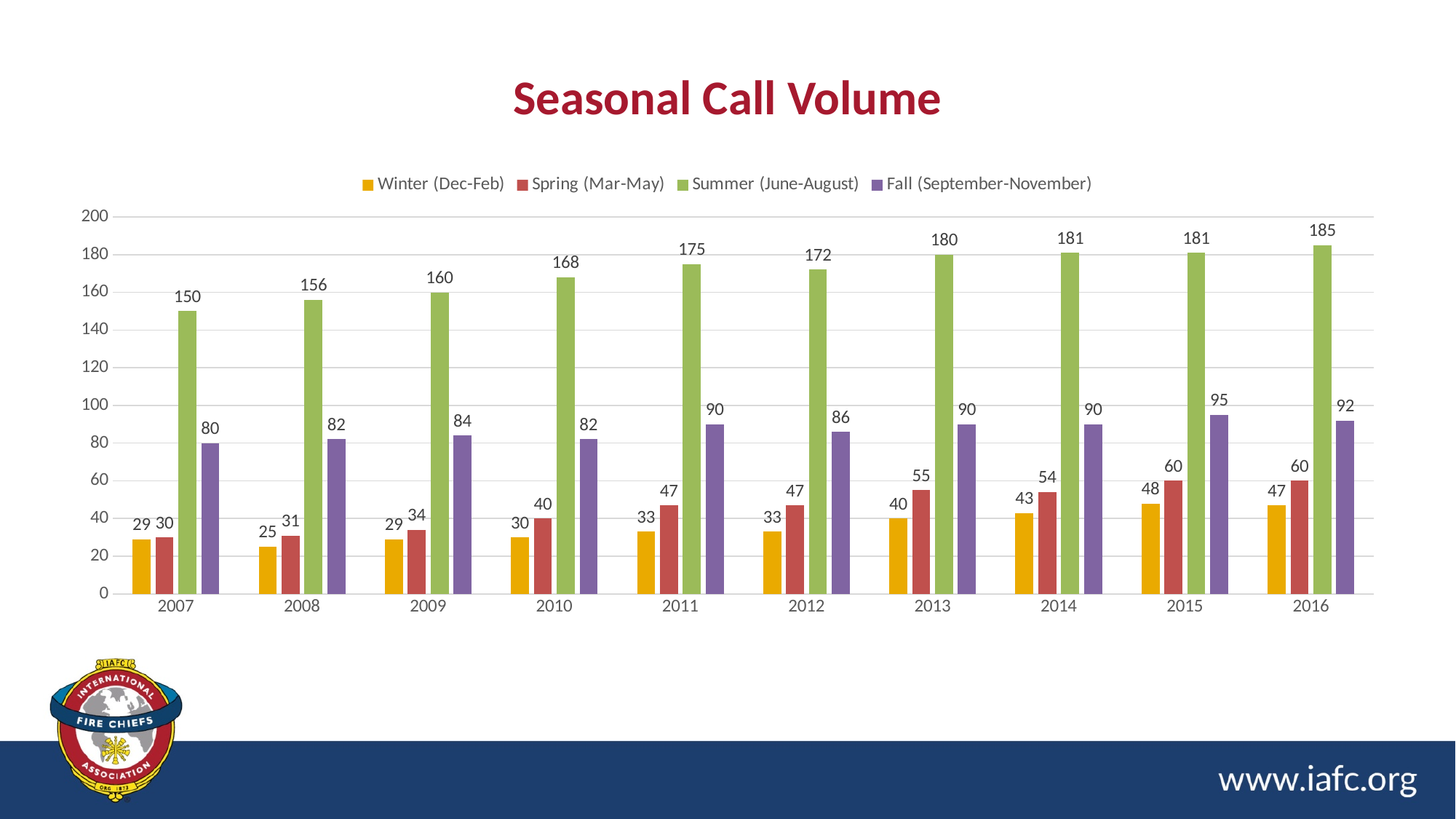
Which year has the highest Summer (June-August) call volume? 2016 What is the Fall (September-November) call volume for 2015? 95 What is the title of the chart? Seasonal Call Volume Which year has the lowest Winter (Dec-Feb) call volume? 2008 How many series does the legend list? 4 What is the difference between the Summer (June-August) and Fall (September-November) call volumes in 2016? 93 Does the Summer (June-August) call volume generally rise or fall from 2007 to 2016? Rise How many years are shown on the x axis? 10 What is the Summer (June-August) call volume for 2011? 175 Which is larger in 2013: the Spring (Mar-May) value or the Winter (Dec-Feb) value? Spring (Mar-May) What is the Winter (Dec-Feb) call volume for 2008? 25 What kind of chart is shown on the slide? Bar chart